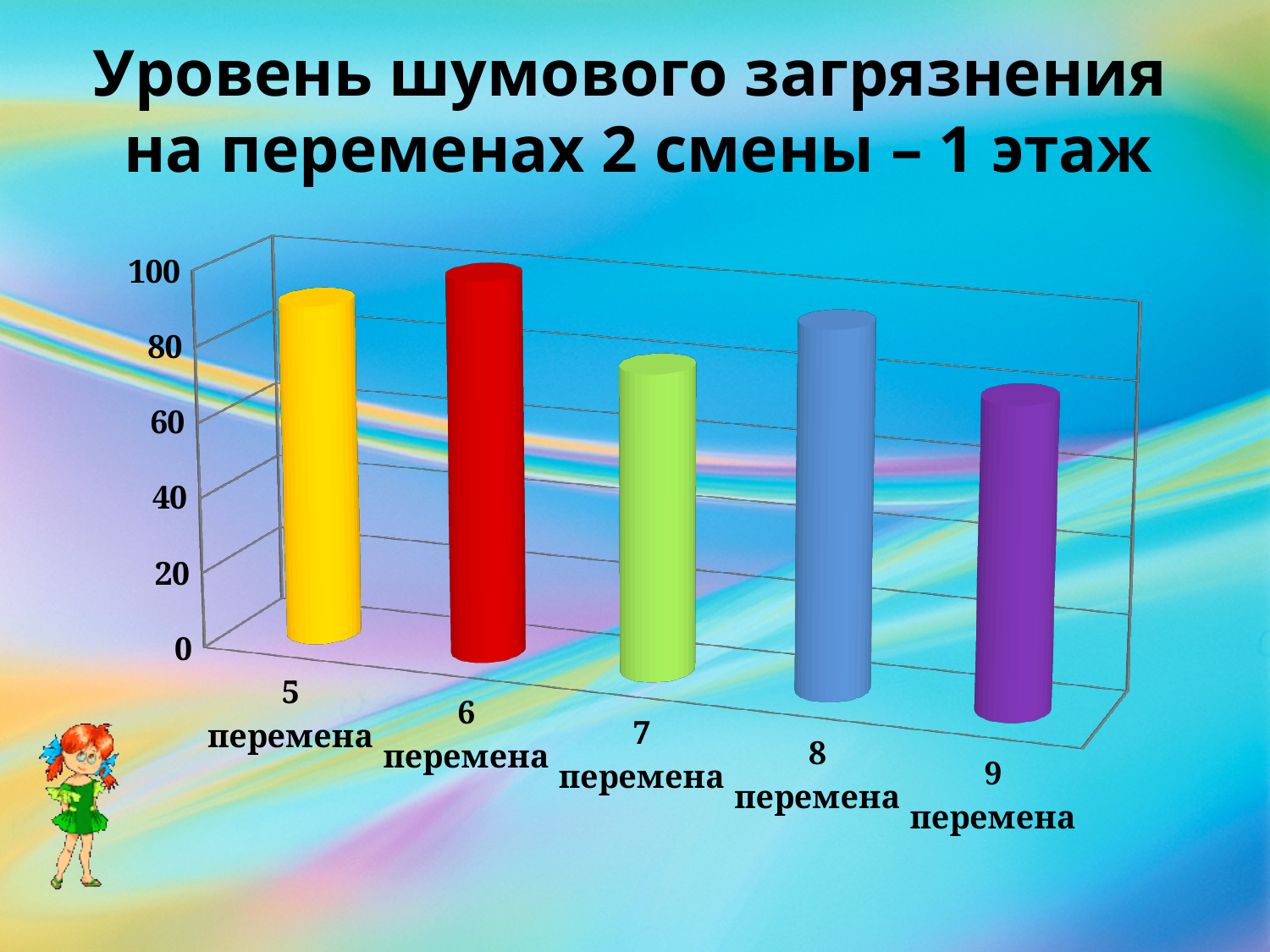
Is the value for 6 перемена greater or less than 80? greater What colour is the bar for 6 перемена? red Is the value for 7 перемена greater or less than 40? greater Which is larger, the value for 6 перемена or the value for 9 перемена? 6 перемена Is the value for 9 перемена greater or less than 100? less Which перемена has the highest noise level on the chart? 6 перемена How many categories (перемены) are plotted on the chart? 5 Which is larger, the value for 5 перемена or the value for 7 перемена? 5 перемена What kind of chart is shown on the slide? bar chart What is the title of the slide's chart? Уровень шумового загрязнения на переменах 2 смены – 1 этаж